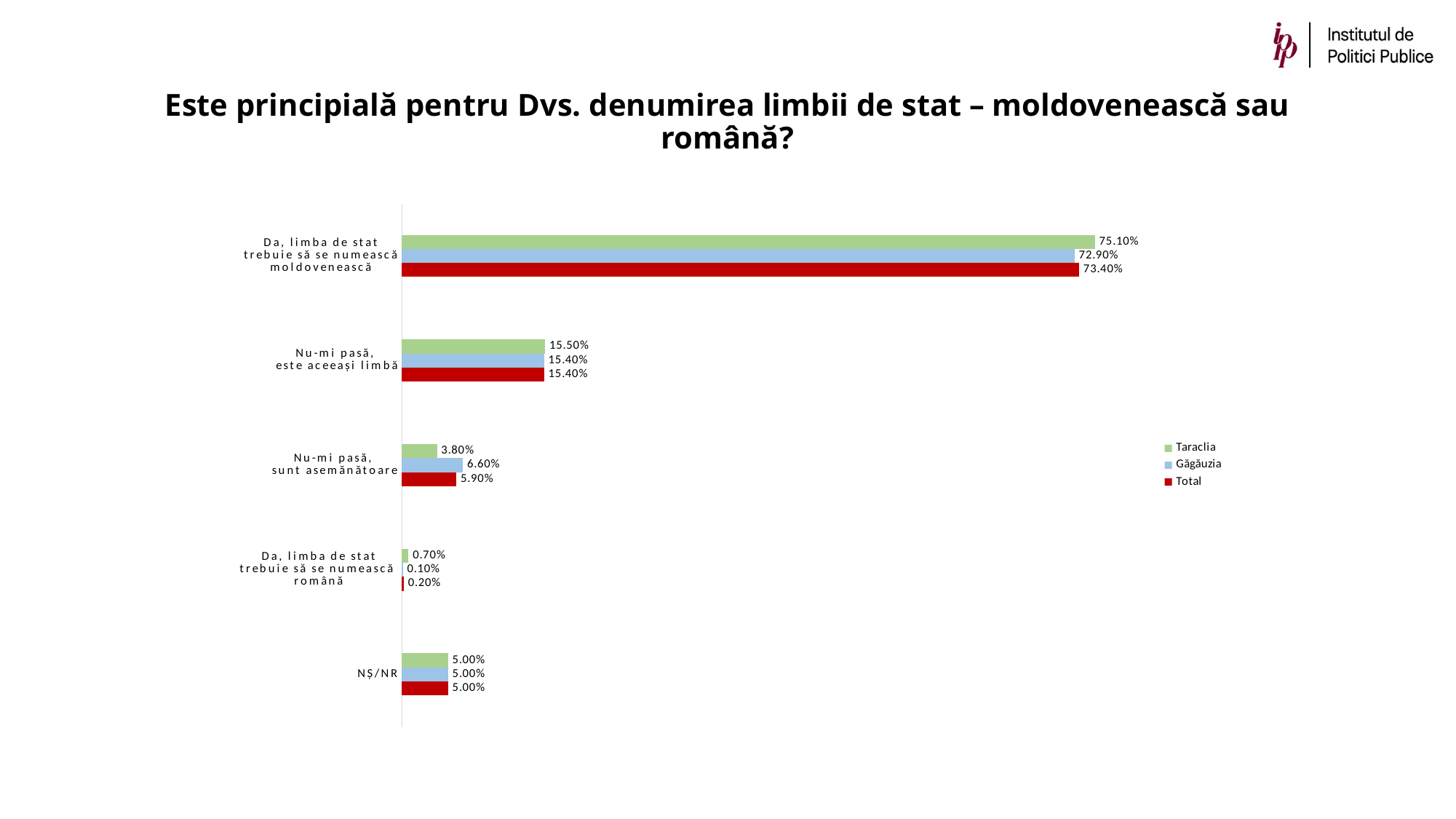
For "Nu-mi pasă, sunt asemănătoare", which is larger: the Taraclia value or the Găgăuzia value? Găgăuzia How many response categories are shown on the chart? 5 Which category has the lowest Taraclia value? Da, limba de stat trebuie să se numească română What is the difference between the Găgăuzia and Taraclia values for "Nu-mi pasă, sunt asemănătoare"? 2.80% What is the Taraclia value for "Da, limba de stat trebuie să se numească moldovenească"? 75.10% What kind of chart is shown on the slide? Bar chart Which category has the highest Total value? Da, limba de stat trebuie să se numească moldovenească What is the Total value for "Nu-mi pasă, sunt asemănătoare"? 5.90% What is the difference between the Taraclia and Găgăuzia values for "Da, limba de stat trebuie să se numească moldovenească"? 2.20% What is the Găgăuzia value for "Da, limba de stat trebuie să se numească română"? 0.10% What is the Găgăuzia value for "Nu-mi pasă, este aceeași limbă"? 15.40% How many series does the legend list? 3